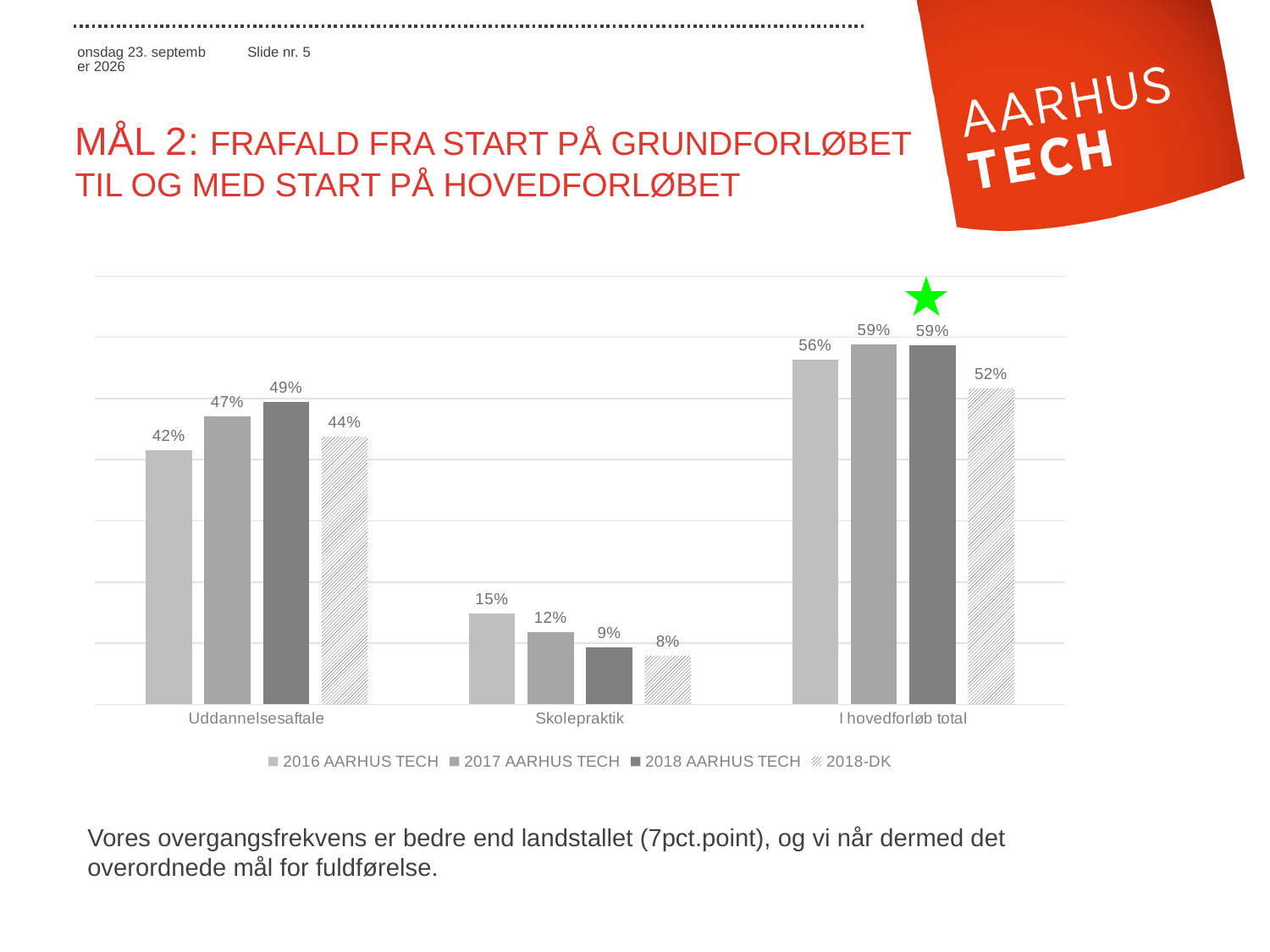
Which series has the highest value in the Skolepraktik category? 2016 AARHUS TECH Which is larger in the Uddannelsesaftale category: 2018 AARHUS TECH or 2018-DK? 2018 AARHUS TECH Do the AARHUS TECH values in the Skolepraktik category rise or fall from 2016 to 2018? Fall What is the value for 2016 AARHUS TECH in the Uddannelsesaftale category? 42% Which series has the lowest value in the I hovedforløb total category? 2018-DK What is the value for 2018-DK in the Skolepraktik category? 8% How many series does the legend list? 4 Which series in the legend is shown with a hatched pattern? 2018-DK How many categories are shown on the x axis? 3 What is the difference between 2018 AARHUS TECH and 2018-DK in the I hovedforløb total category? 7% What is the value for 2017 AARHUS TECH in the I hovedforløb total category? 59% What kind of chart is shown on the slide? Bar chart